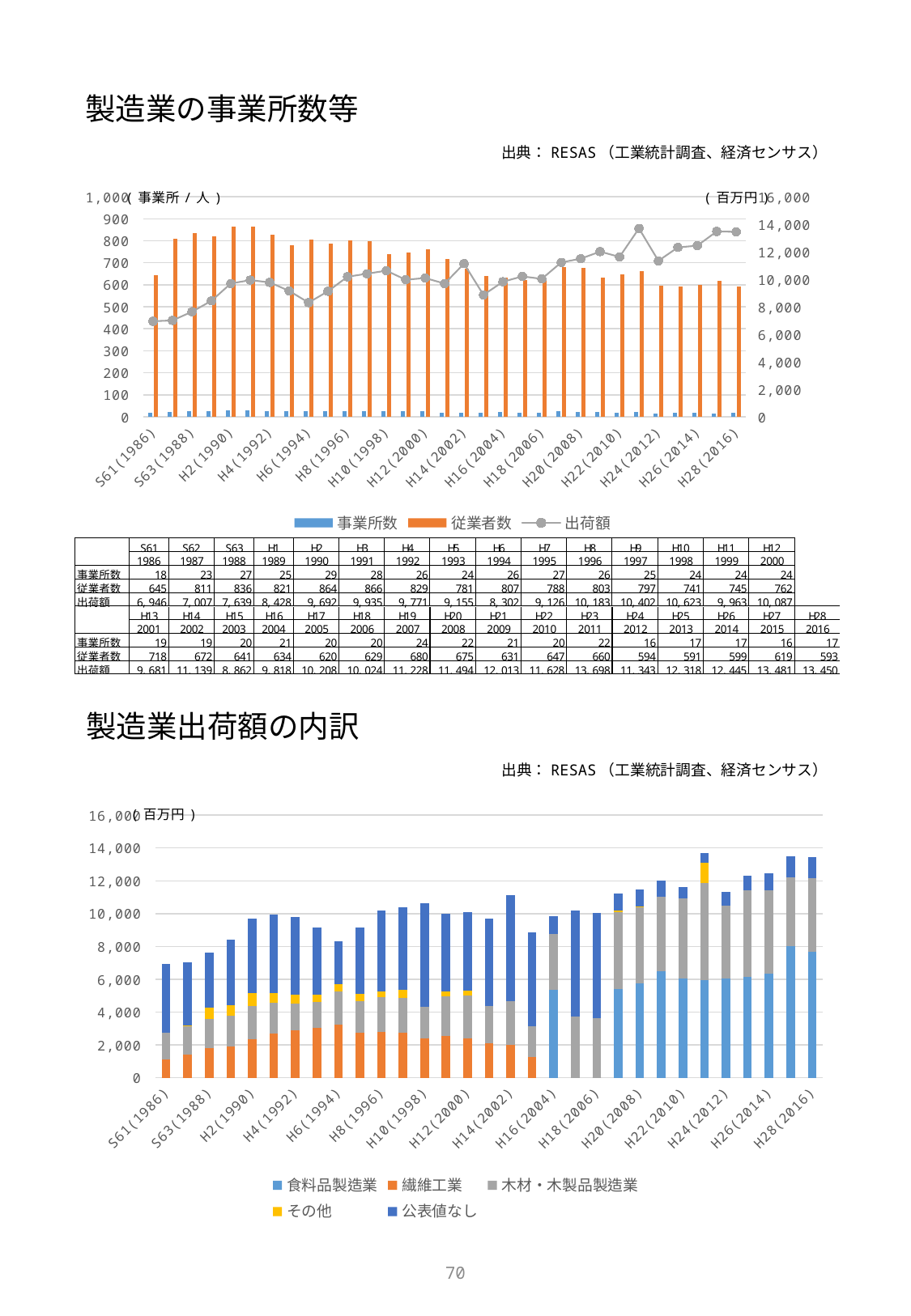
In the top chart 製造業の事業所数等, is the 従業者数 for S61(1986) or for S62(1987) larger? S62(1987) In the top chart 製造業の事業所数等, what unit label is shown on the right axis? 百万円 In the top chart 製造業の事業所数等, what is the difference in 事業所数 between H2(1990) and H28(2016)? 12 In the bottom chart 製造業出荷額の内訳, is the total bar for H28(2016) greater or less than 12,000? greater In the top chart 製造業の事業所数等, how many series does the legend list? 3 In the bottom chart 製造業出荷額の内訳, is the total bar for S61(1986) greater or less than 8,000? less In the top chart 製造業の事業所数等, which year has the lowest 出荷額? S61(1986) In the top chart 製造業の事業所数等, what is the 出荷額 value for H23(2011) according to the table? 13,698 In the bottom chart 製造業出荷額の内訳, how many series does the legend list? 5 In the top chart 製造業の事業所数等, which year has the highest 従業者数? H3(1991) In the top chart 製造業の事業所数等, what is the 従業者数 value for S61(1986) according to the table? 645 In the bottom chart 製造業出荷額の内訳, what kind of chart is it? Stacked bar chart